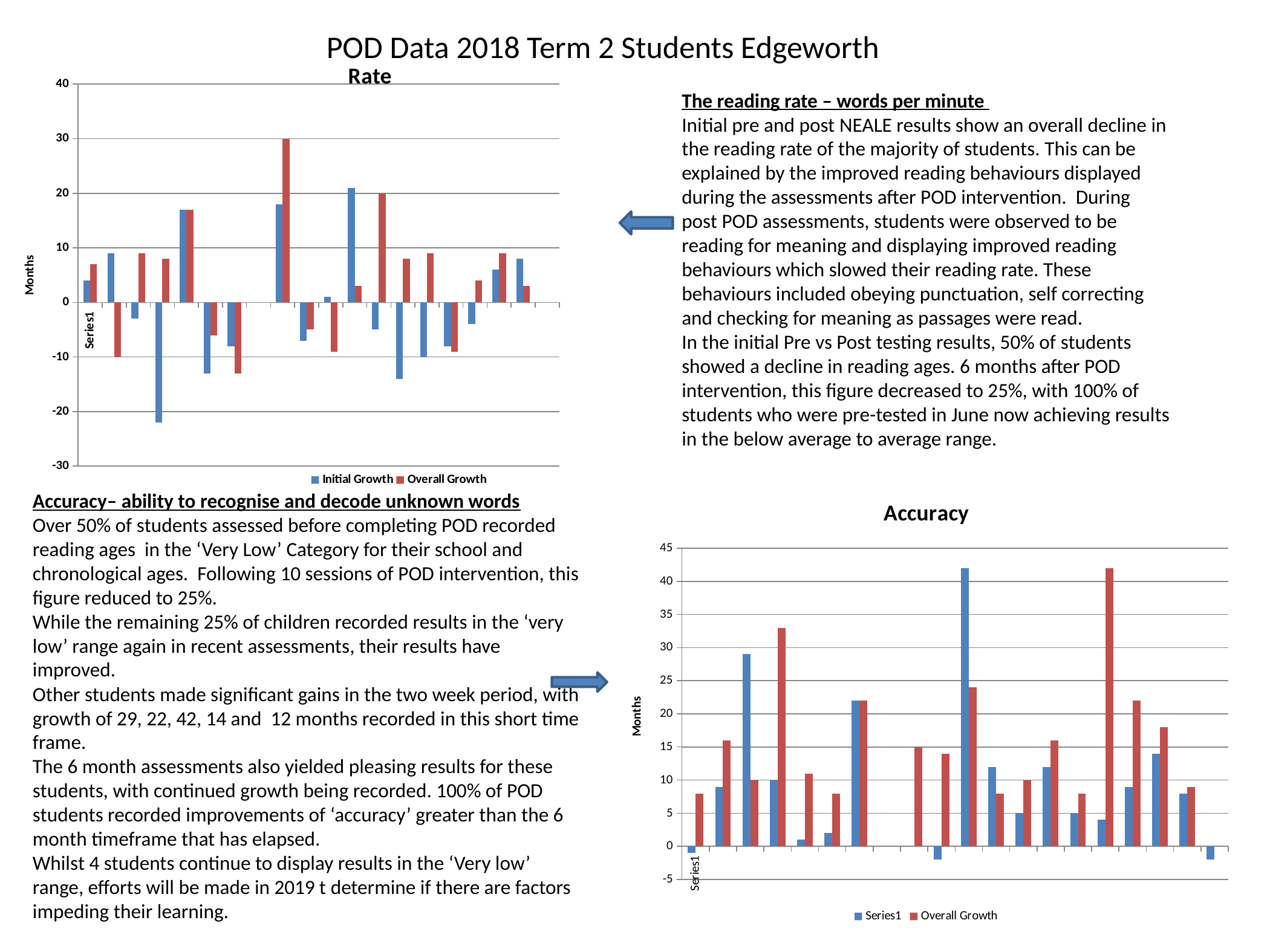
What kind of chart is the Rate chart? bar chart How many series does the legend of the Rate chart list? 2 In the Accuracy chart, is the tallest Overall Growth (red) bar greater or less than 35? greater In the Rate chart, which series has the tallest bar, Initial Growth or Overall Growth? Overall Growth In the Accuracy chart, is the tallest Series1 (blue) bar greater or less than 35? greater What kind of chart is the Accuracy chart? bar chart In the Rate chart, is the lowest Initial Growth (blue) bar greater or less than -20? less What is the label on the vertical axis of the Accuracy chart? Months What are the two legend entries of the Rate chart? Initial Growth and Overall Growth How many series does the legend of the Accuracy chart list? 2